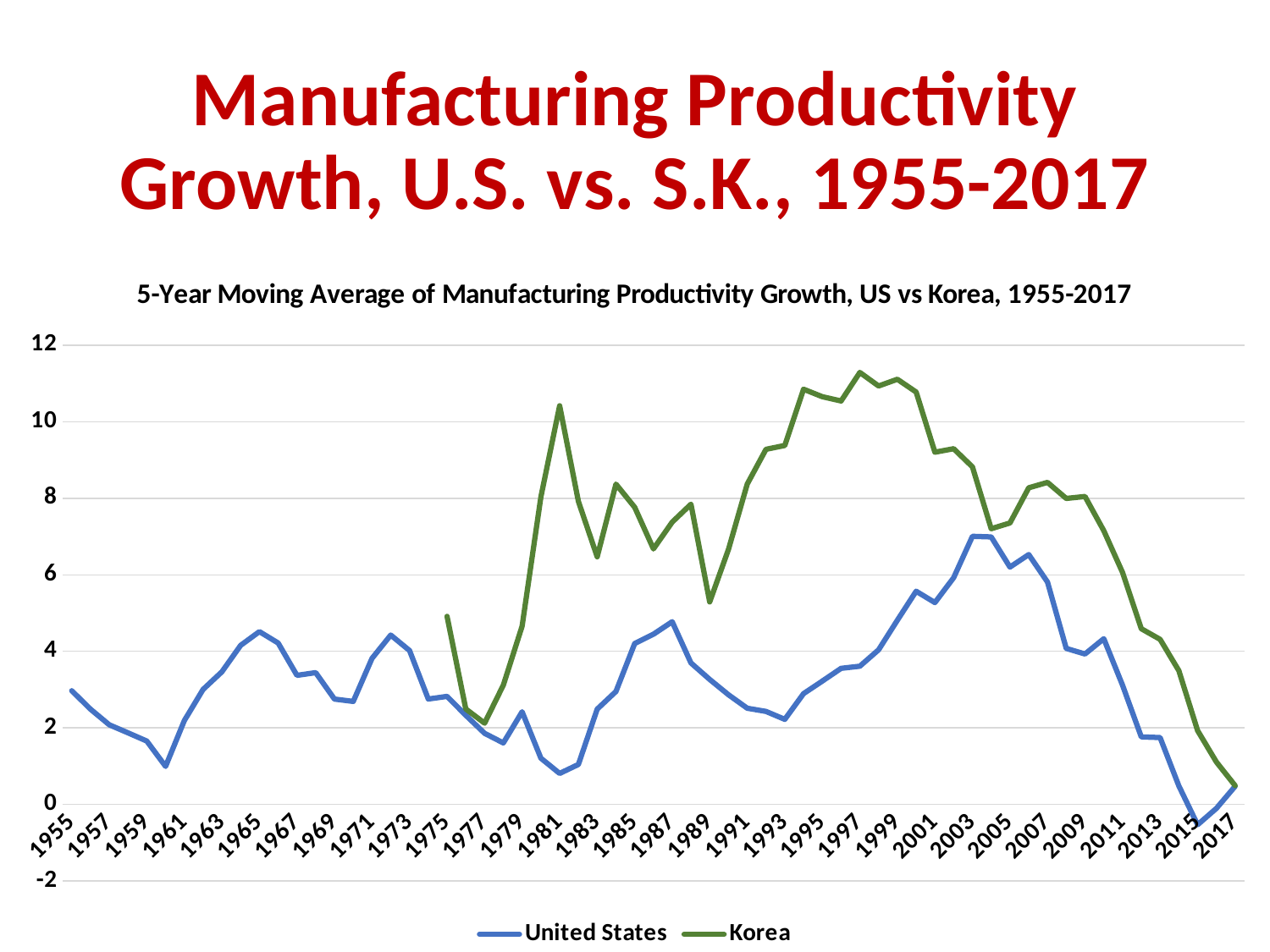
Which series reaches the highest value anywhere on the chart? Korea What are the two series named in the legend? United States and Korea Is the value for the United States in 2003 greater or less than 6? greater In 1997, which series has the larger value, United States or Korea? Korea How many series does the legend list? 2 What kind of chart is shown on the slide? line chart Is the value for Korea in 2017 greater or less than 2? less What is the title printed above the chart area? 5-Year Moving Average of Manufacturing Productivity Growth, US vs Korea, 1955-2017 Is the value for Korea in 1997 greater or less than 10? greater Does the United States line rise or fall from 2003 to 2015? fall